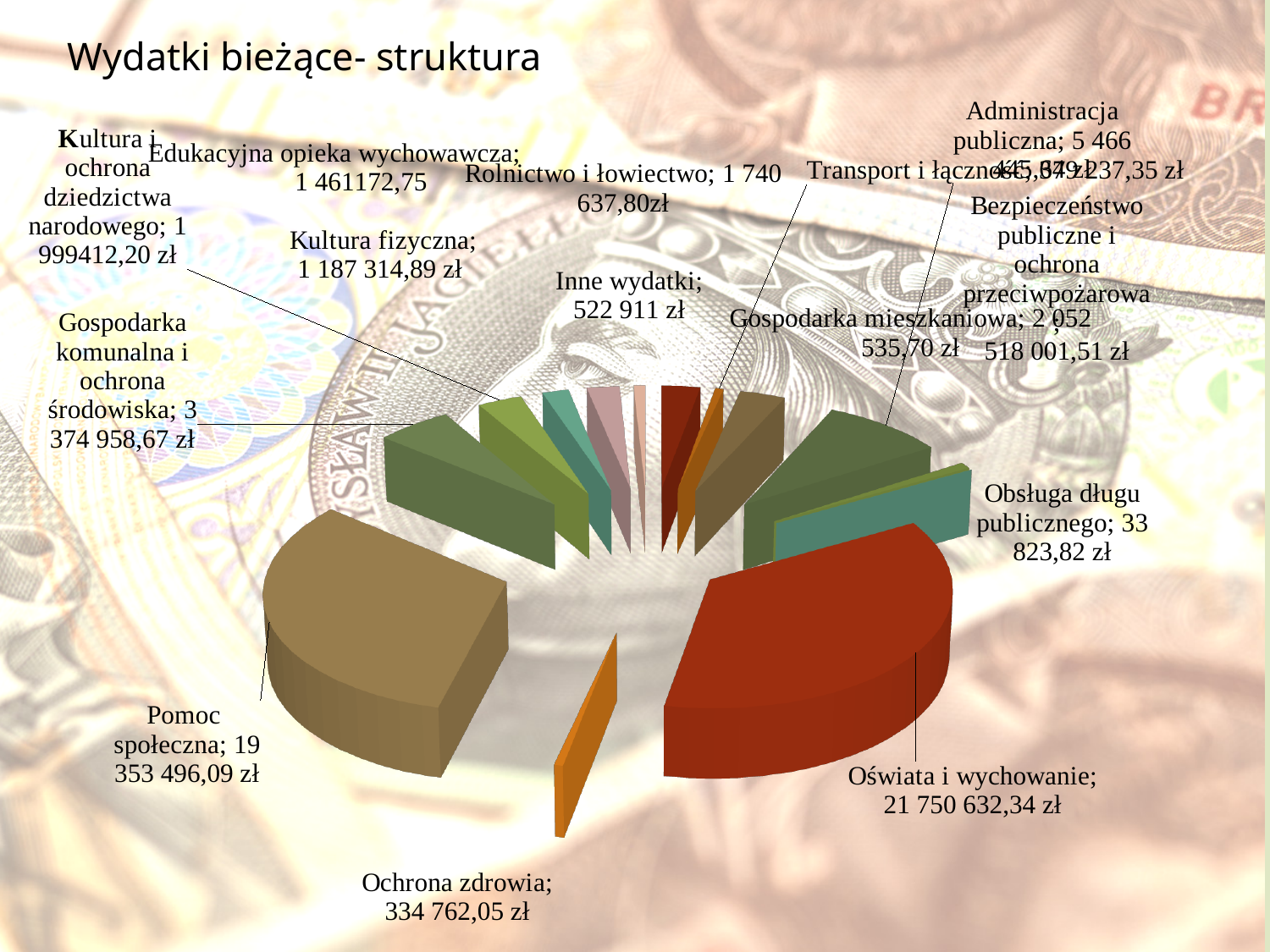
Which category has the largest slice of the pie? Oświata i wychowanie Which is larger, Rolnictwo i łowiectwo or Kultura fizyczna? Rolnictwo i łowiectwo What is the difference between Gospodarka komunalna i ochrona środowiska and Gospodarka mieszkaniowa? 1 322 422,97 zł Which category has the smallest slice of the pie? Obsługa długu publicznego What is the difference between the values for Oświata i wychowanie and Pomoc społeczna? 2 397 136,25 zł What is the value for Oświata i wychowanie? 21 750 632,34 zł What is the title of the chart on the slide? Wydatki bieżące- struktura What is the value for Gospodarka komunalna i ochrona środowiska? 3 374 958,67 zł What is the value for Ochrona zdrowia? 334 762,05 zł What is the value for Obsługa długu publicznego? 33 823,82 zł What type of chart is shown on the slide? Pie chart What is the value for Pomoc społeczna? 19 353 496,09 zł